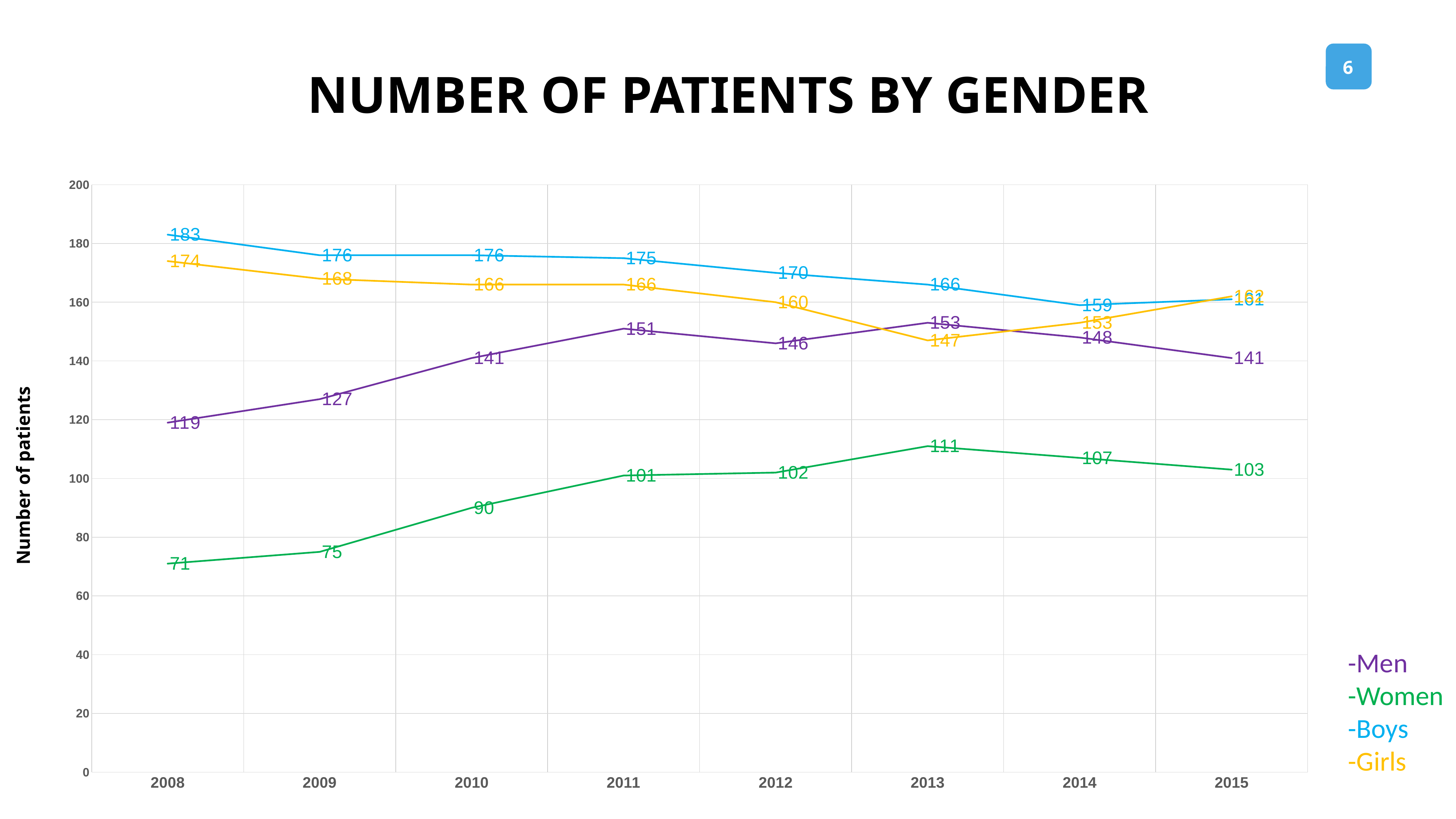
What is the number of Girls patients in 2012? 160 Does the Women series rise or fall from 2008 to 2011? rise What kind of chart is shown on the slide? line chart What is the number of Women patients in 2013? 111 What is the number of Boys patients in 2008? 183 Which is larger: the Men value in 2011 or the Girls value in 2013? Men in 2011 What is the number of Men patients in 2008? 119 In which year is the Men series at its lowest? 2008 How many years are plotted along the x axis? 8 What is the difference between the Boys value in 2008 and the Boys value in 2014? 24 How many series does the legend list? 4 In which year is the Women series at its highest? 2013